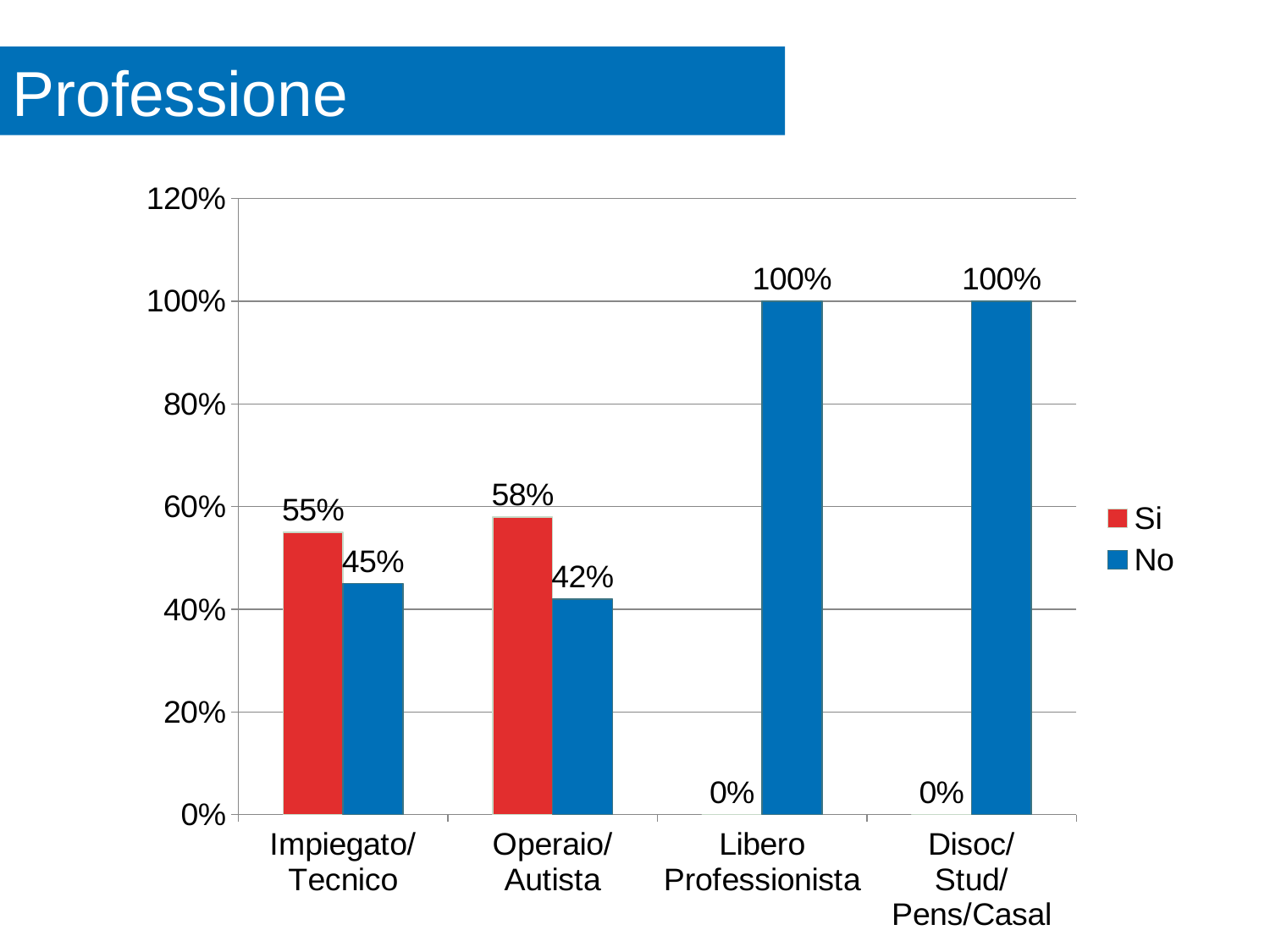
Which is larger for Impiegato/Tecnico, the Si value or the No value? Si What is the No value for Disoc/Stud/Pens/Casal? 100% Which category has the lowest No value? Operaio/Autista What kind of chart is shown on the slide? Bar chart What colour represents the No series? Blue How many categories are shown on the x axis? 4 What is the difference between the Si and No values for Operaio/Autista? 16% What is the Si value for Impiegato/Tecnico? 55% How many series does the legend list? 2 What is the Si value for Libero Professionista? 0% What is the No value for Operaio/Autista? 42% Which category has the highest Si value? Operaio/Autista